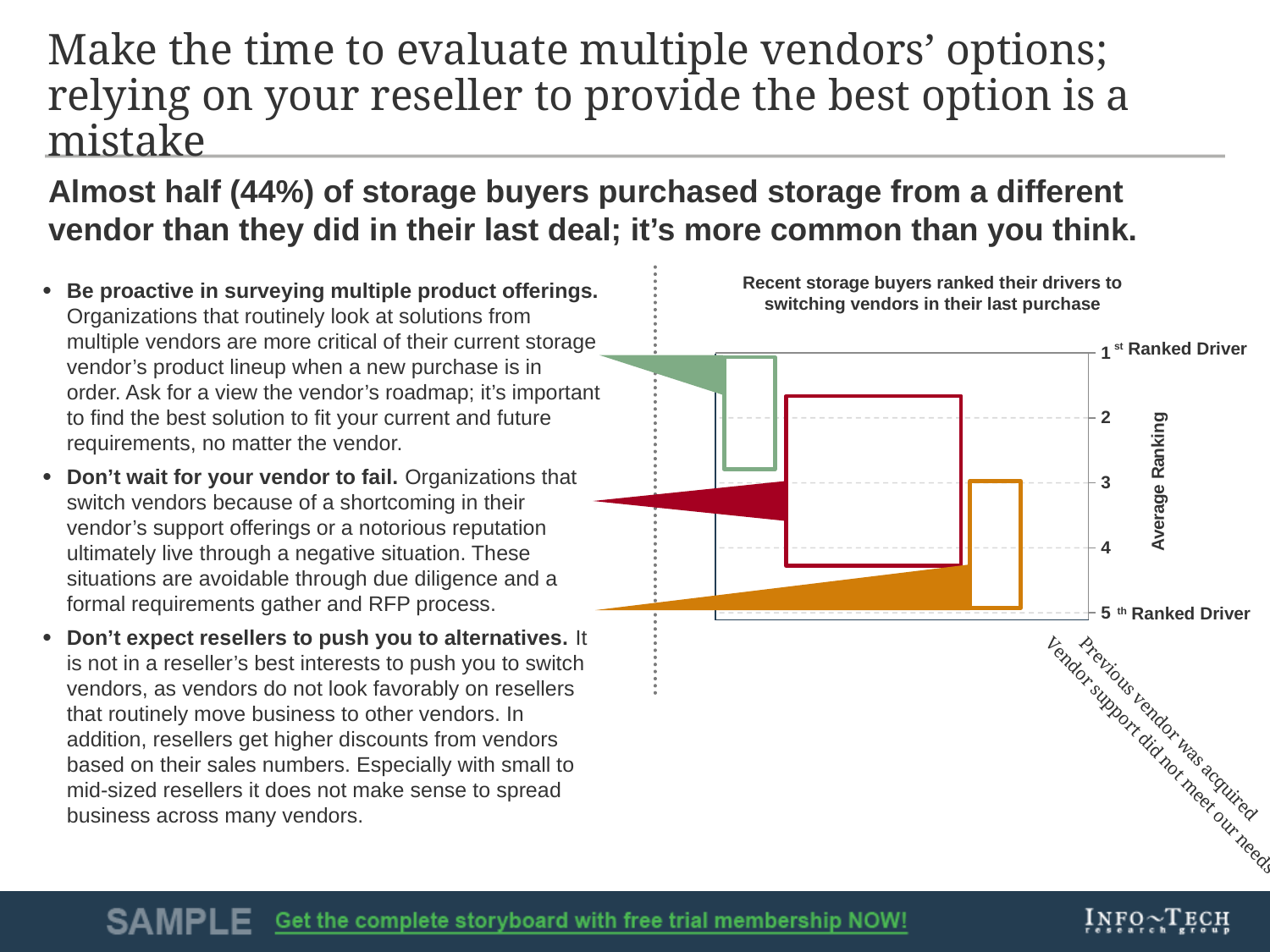
Which bar extends closest to the '1st Ranked Driver' end of the axis? the green bar What is the label on the vertical axis of the chart? Average Ranking What label is shown at the top of the vertical axis? 1st Ranked Driver What kind of chart is shown on the slide? bar chart What is the title of the chart? Recent storage buyers ranked their drivers to switching vendors in their last purchase Which bar extends closest to the '5th Ranked Driver' end of the axis? the orange bar